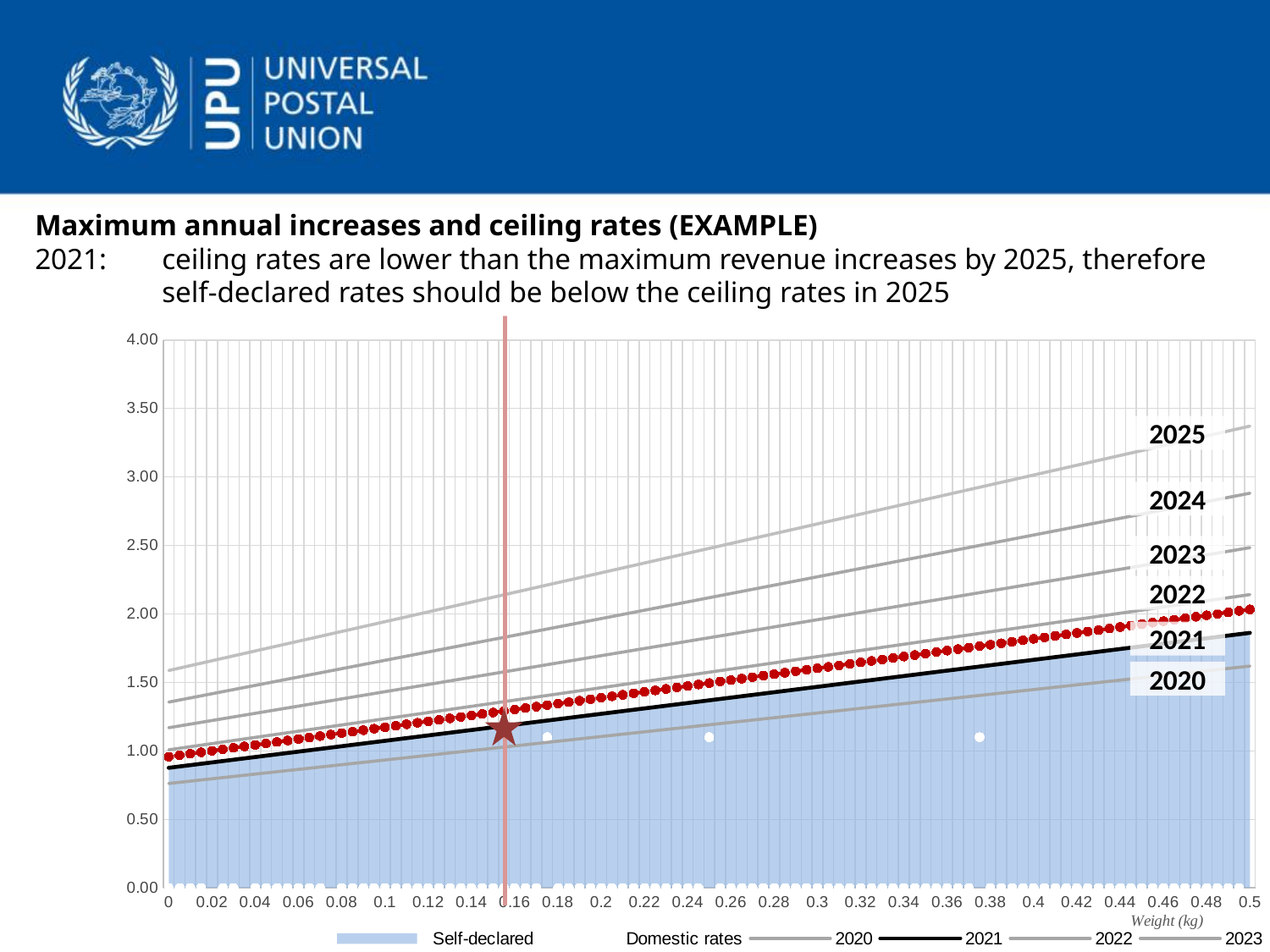
Which line is lowest at 0.5 kg? 2020 How many entries does the chart legend list? 6 At 0 kg, which is higher: the 2025 line or the 2022 line? 2025 Is the value of the 2020 line at 0 kg greater or less than 1.00? less Which line is highest at 0.5 kg? 2025 What is the label of the x axis of the chart? Weight (kg) Is the value of the 2025 line at 0.5 kg greater or less than 3.00? greater What is the highest value shown on the y axis of the chart? 4.00 Do the rate lines rise or fall as weight increases along the x axis? rise What kind of chart is shown on the slide? combination area and line chart Is the value of the 2021 line at 0.5 kg greater or less than 2.00? less